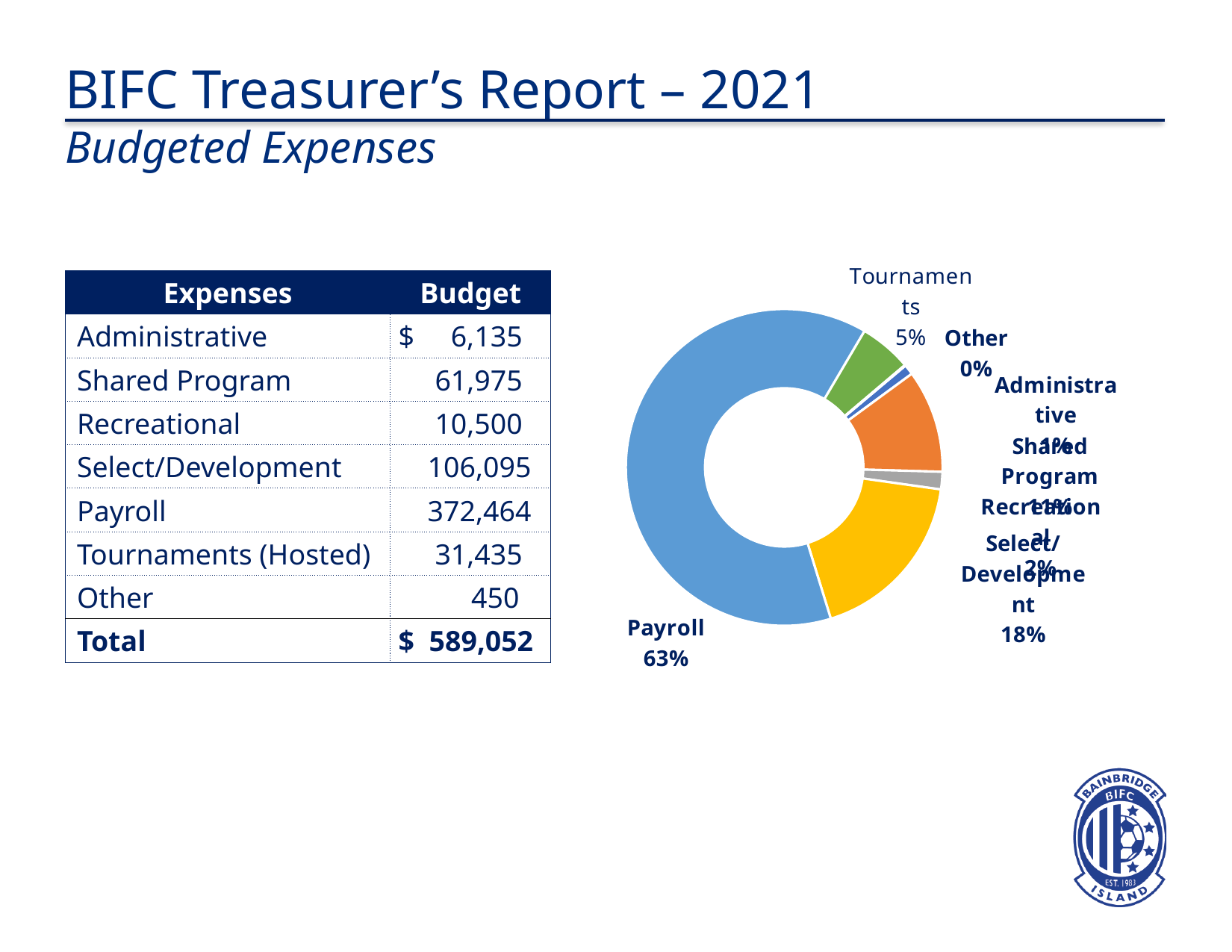
What share of budgeted expenses does Other represent in the chart? 0% What share of budgeted expenses does Payroll represent in the chart? 63% What is the subtitle of the slide describing what the chart shows? Budgeted Expenses Which slice is larger in the chart, Select/Development or Tournaments? Select/Development How many expense categories are plotted in the chart? 7 Which expense category has the largest slice in the chart? Payroll What share of budgeted expenses do Tournaments represent in the chart? 5% What kind of chart is shown on the slide? Doughnut (pie) chart What colour is the Payroll slice in the chart? Blue Which expense category has the smallest slice in the chart? Other What is the difference in percentage points between the Payroll and Select/Development slices? 45 percentage points